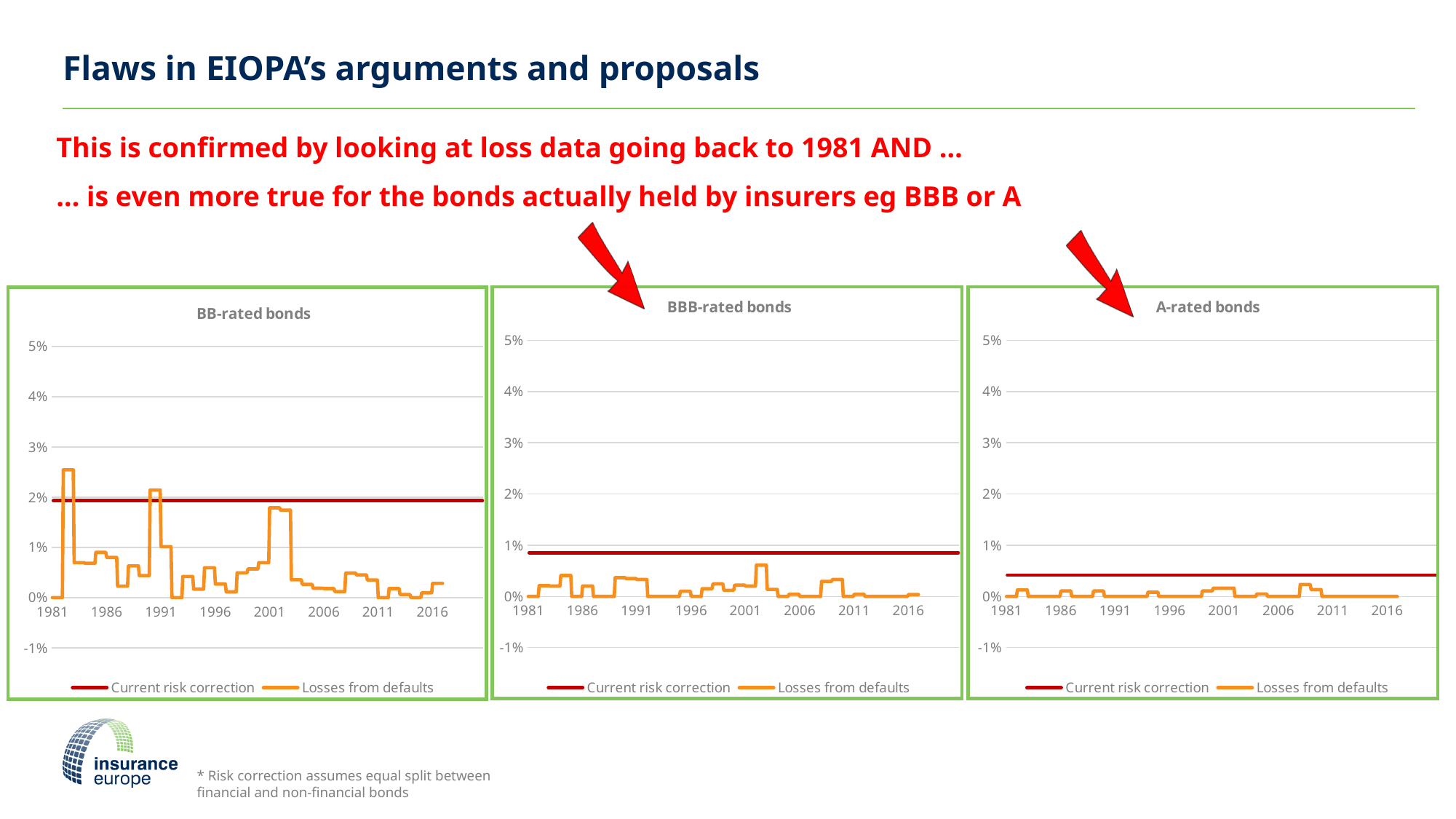
In the 'BB-rated bonds' chart, is the peak value of 'Losses from defaults' around 1982 greater or less than 2%? greater How many series does the legend of the 'BBB-rated bonds' chart list? 2 What kind of chart is the 'BB-rated bonds' chart? line chart In the 'BBB-rated bonds' chart, is the highest value of 'Losses from defaults' greater or less than 1%? less In the 'A-rated bonds' chart, which series is higher throughout the period: 'Current risk correction' or 'Losses from defaults'? Current risk correction In the 'A-rated bonds' chart, is the highest value of 'Losses from defaults' greater or less than 1%? less What is the title of the chart on the right of the slide? A-rated bonds In the 'BB-rated bonds' chart, what colour is the 'Losses from defaults' line? orange How many charts are shown on the slide? 3 In the 'BB-rated bonds' chart, which is larger: the 'Current risk correction' line or the peak of 'Losses from defaults' around 1982? Losses from defaults